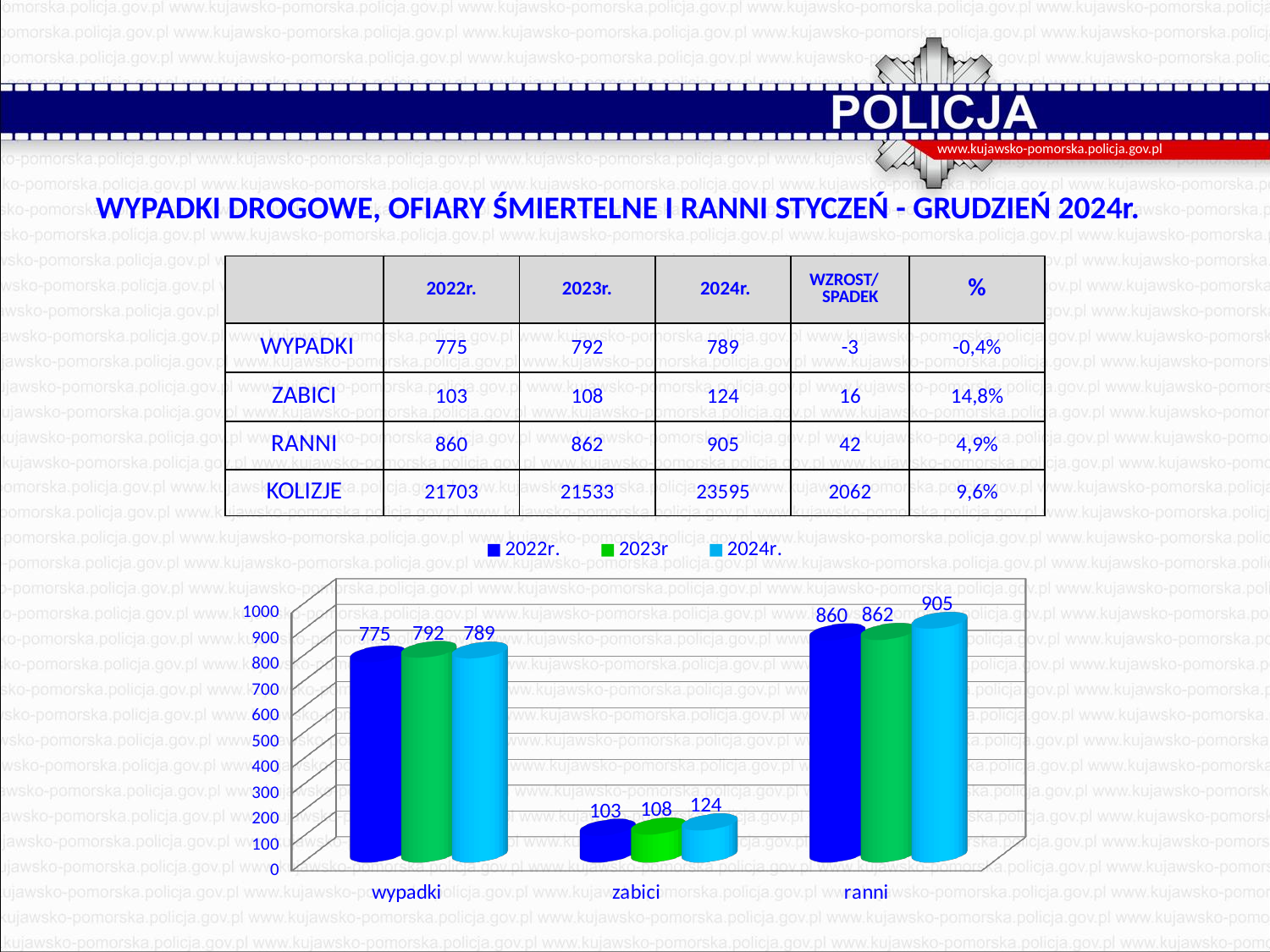
What is the value for zabici in the 2024r. series? 124 What is the value for wypadki in the 2022r. series? 775 How many series does the chart legend list? 3 What is the difference between the 2024r. and 2022r. values for ranni? 45 What is the value for ranni in the 2023r series? 862 Which is larger for wypadki: the 2023r value or the 2024r. value? 2023r Which category has the highest value in the 2024r. series? ranni Is the 2022r. value for ranni greater or less than 800? greater Do the values for zabici rise or fall from 2022r. to 2024r.? rise What type of chart is shown on the slide? bar chart Which category has the lowest values in the chart? zabici How many categories are shown on the x axis of the chart? 3